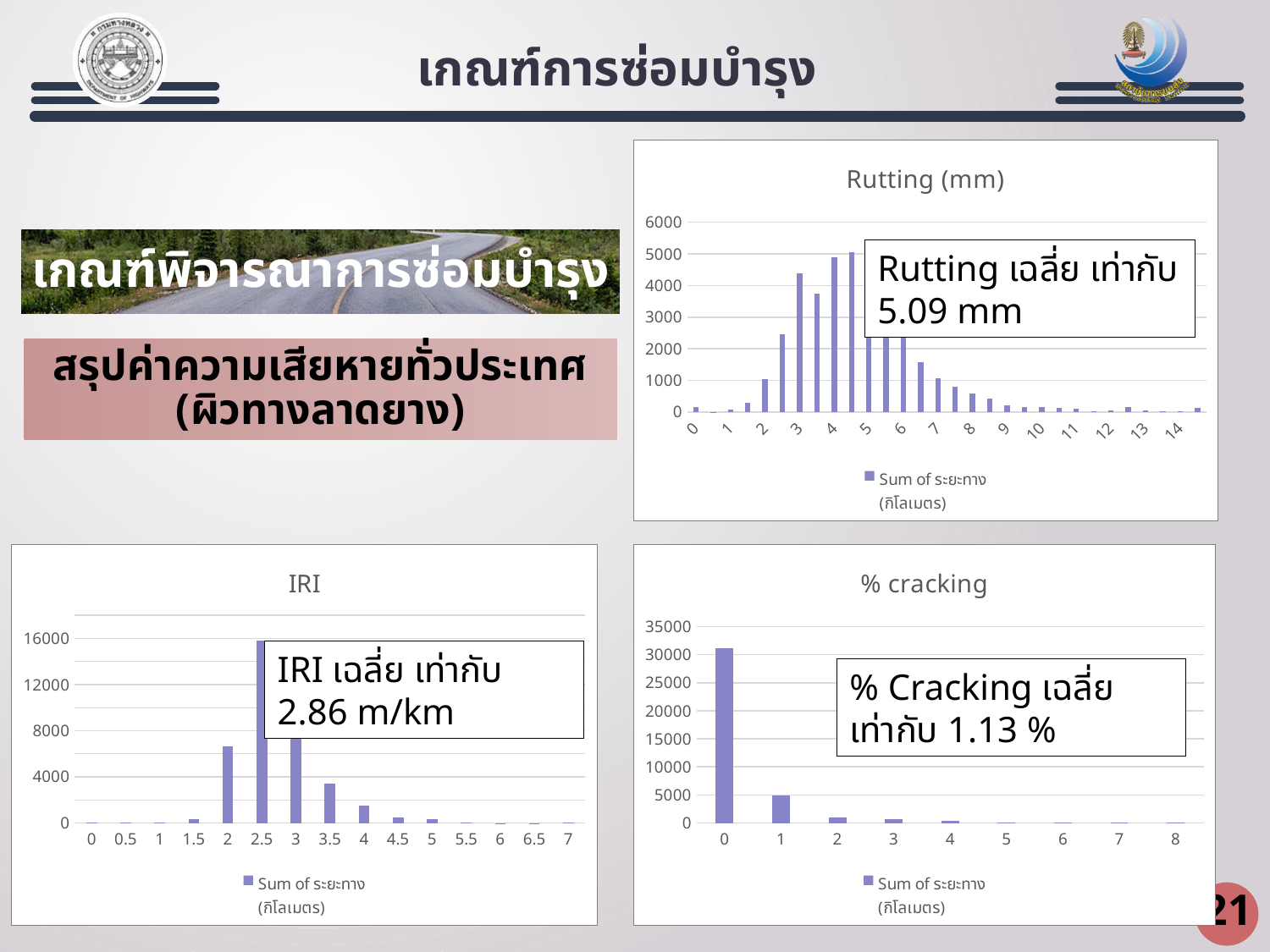
In the 'IRI' chart, is the value for category 3.5 greater or less than 4000? less In the 'IRI' chart, which of categories 2 and 3 has the larger value? 3 In the '% cracking' chart, do the values rise or fall as the x-axis increases from 0 to 8? fall What kind of chart is the 'Rutting (mm)' chart? bar chart How many categories are labelled on the x axis of the '% cracking' chart? 9 In the '% cracking' chart, is the value for category 0 greater or less than 25000? greater In the 'IRI' chart, is the value for category 2 greater or less than 4000? greater What is the title of the chart in the top right of the slide? Rutting (mm) In the 'IRI' chart, which x-axis category has the highest bar? 2.5 How many series does the legend of the 'IRI' chart list? 1 In the '% cracking' chart, which x-axis category has the highest bar? 0